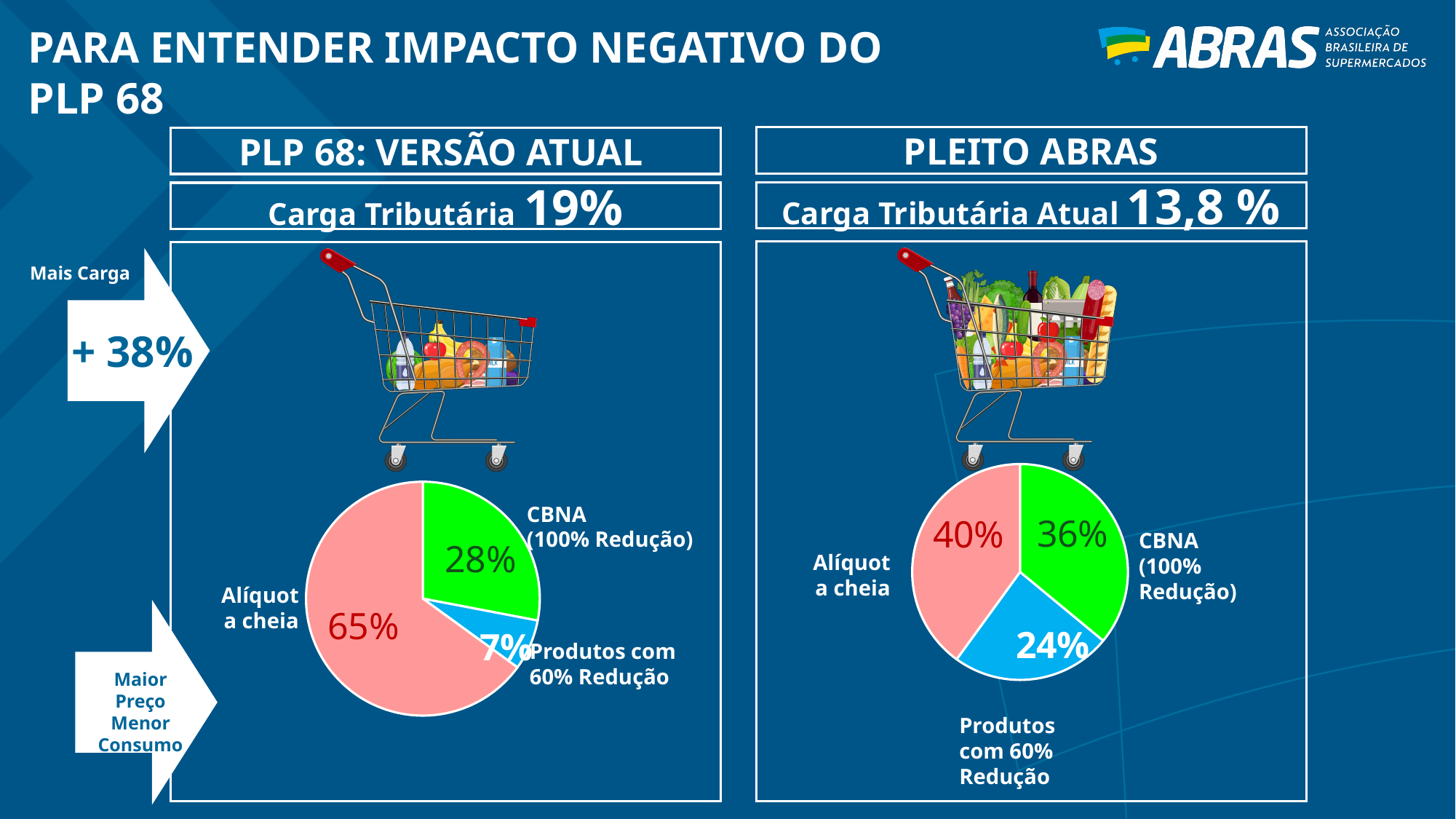
In the left pie chart (PLP 68: Versão Atual), what share is labelled for Produtos com 60% Redução? 7% In the right pie chart (Pleito ABRAS), which is larger: the Alíquota cheia slice or the CBNA (100% Redução) slice? Alíquota cheia In the right pie chart (Pleito ABRAS), what share is labelled for Produtos com 60% Redução? 24% In the right pie chart (Pleito ABRAS), what share is labelled for Alíquota cheia? 40% In the left pie chart (PLP 68: Versão Atual), which category has the largest slice? Alíquota cheia In the right pie chart (Pleito ABRAS), what share is labelled for CBNA (100% Redução)? 36% In the left pie chart (PLP 68: Versão Atual), what share is labelled for CBNA (100% Redução)? 28% How many slices does the right pie chart (Pleito ABRAS) have? 3 In the left pie chart (PLP 68: Versão Atual), what share is labelled for Alíquota cheia? 65% What type of chart is shown under the PLP 68: Versão Atual heading? Pie chart In the right pie chart (Pleito ABRAS), which category has the smallest slice? Produtos com 60% Redução In the left pie chart (PLP 68: Versão Atual), what is the difference between the Alíquota cheia share and the CBNA (100% Redução) share? 37%